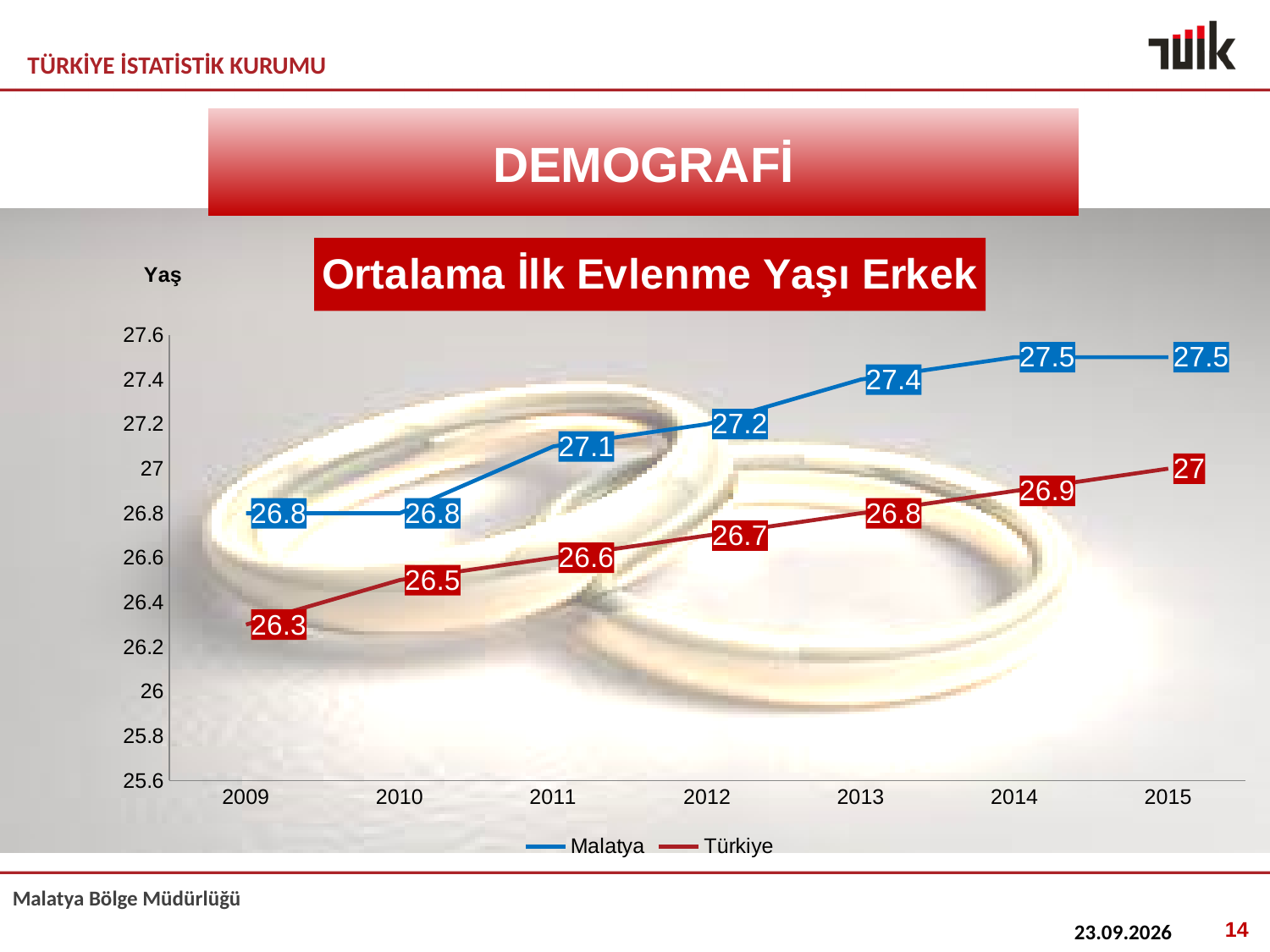
Which is larger in 2013, the Malatya value or the Türkiye value? Malatya What is the difference between the Malatya and Türkiye values in 2009? 0.5 How many series does the legend list? 2 What is the value for Malatya in 2014? 27.5 What is the value for Malatya in 2012? 27.2 What kind of chart is shown? line chart What is the value for Türkiye in 2009? 26.3 In which year is the Türkiye value highest? 2015 Does the Türkiye series rise or fall from 2009 to 2015? rise What is the value for Türkiye in 2015? 27 In which year is the Malatya value lowest? 2009 and 2010 How many years are shown on the x axis? 7